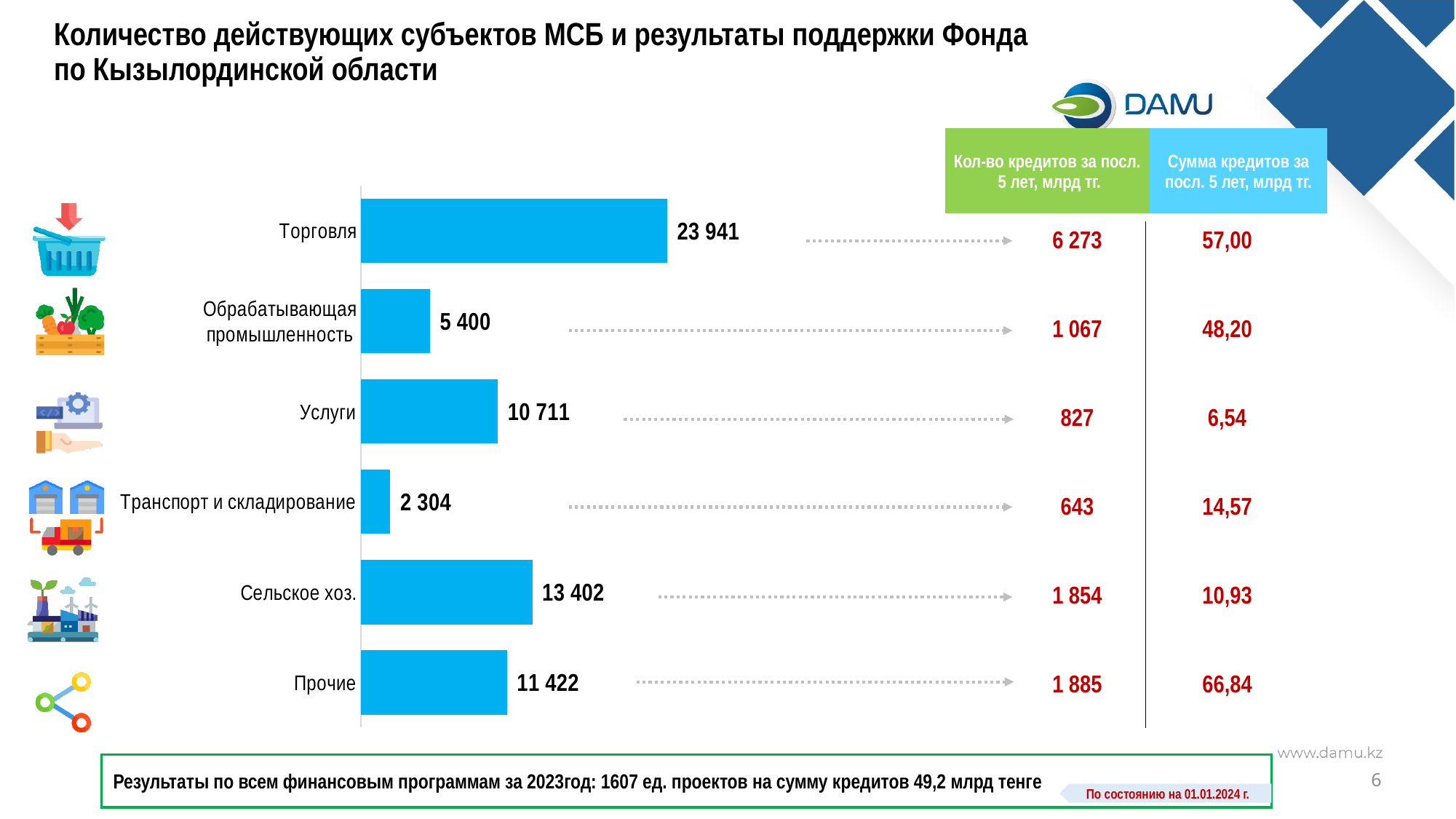
What is the value shown for Сельское хоз.? 13 402 What is the difference between the values for Прочие and Услуги? 711 Which is larger, the value for Обрабатывающая промышленность or the value for Транспорт и складирование? Обрабатывающая промышленность How many categories are shown in the bar chart? 6 Which category has the lowest value in the bar chart? Транспорт и складирование What is the value shown for Обрабатывающая промышленность? 5 400 What type of chart is shown on the slide? Bar chart Which is larger, the value for Услуги or the value for Прочие? Прочие What is the difference between the values for Торговля and Сельское хоз.? 10 539 Which category has the highest value in the bar chart? Торговля What is the value shown for Транспорт и складирование? 2 304 What is the value shown for Торговля? 23 941